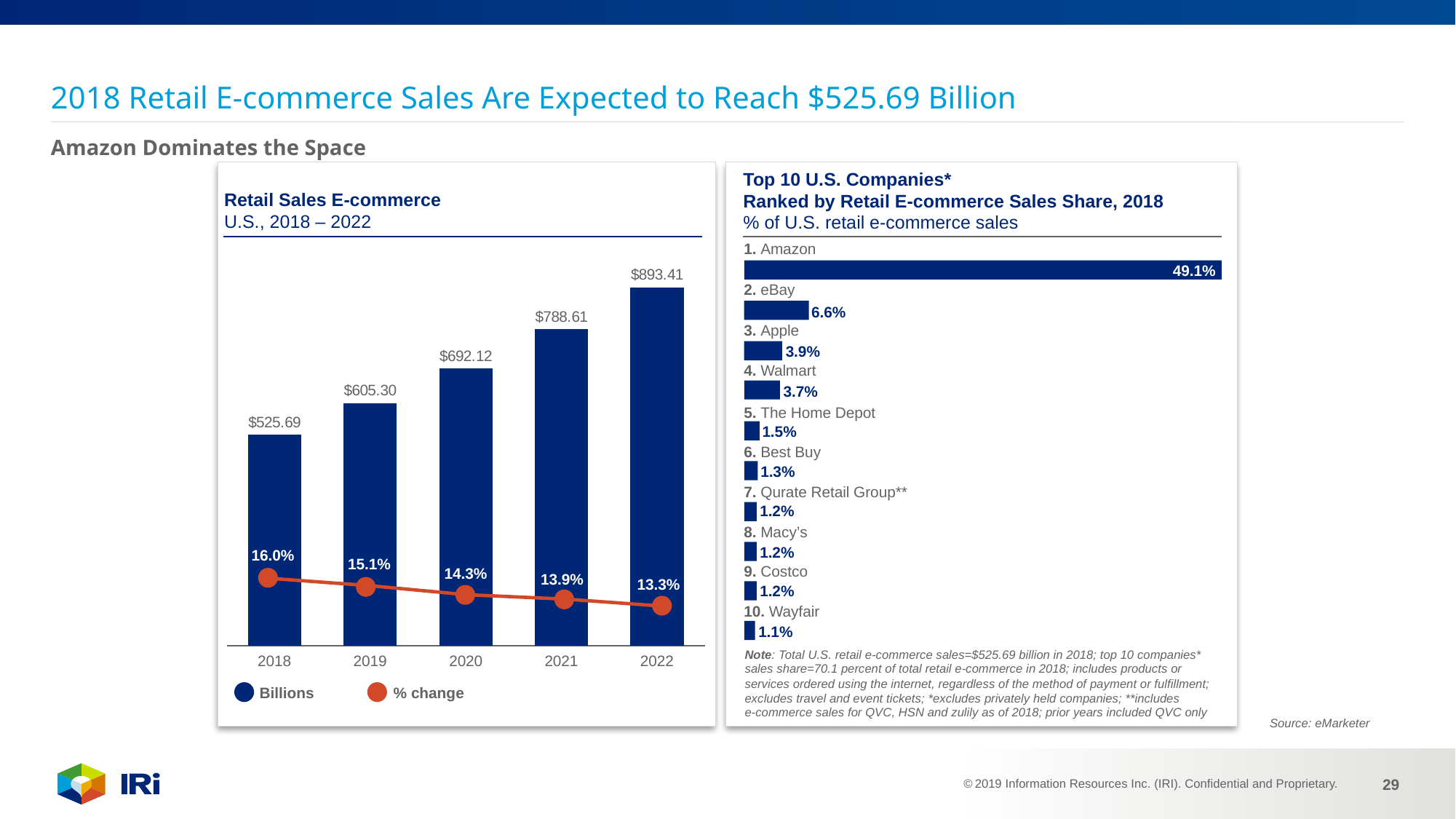
In the 'Retail Sales E-commerce U.S., 2018 – 2022' chart, which year has the highest Billions value? 2022 In the 'Retail Sales E-commerce U.S., 2018 – 2022' chart, what is the % change value for 2019? 15.1% In the 'Top 10 U.S. Companies Ranked by Retail E-commerce Sales Share, 2018' chart, what is the share for eBay? 6.6% What kind of chart is the 'Top 10 U.S. Companies Ranked by Retail E-commerce Sales Share, 2018' chart? bar chart In the 'Retail Sales E-commerce U.S., 2018 – 2022' chart, what is the difference between the Billions values for 2022 and 2021? $104.80 In the 'Retail Sales E-commerce U.S., 2018 – 2022' chart, what is the value of the Billions bar for 2020? $692.12 In the 'Top 10 U.S. Companies Ranked by Retail E-commerce Sales Share, 2018' chart, which company has the lowest share? Wayfair In the 'Retail Sales E-commerce U.S., 2018 – 2022' chart, does the % change line rise or fall from 2018 to 2022? fall In the 'Top 10 U.S. Companies Ranked by Retail E-commerce Sales Share, 2018' chart, which is larger, the share for Apple or the share for Walmart? Apple How many years are shown on the x axis of the 'Retail Sales E-commerce U.S., 2018 – 2022' chart? 5 In the 'Retail Sales E-commerce U.S., 2018 – 2022' chart, which year has the lowest % change? 2022 How many series does the legend of the 'Retail Sales E-commerce U.S., 2018 – 2022' chart list? 2